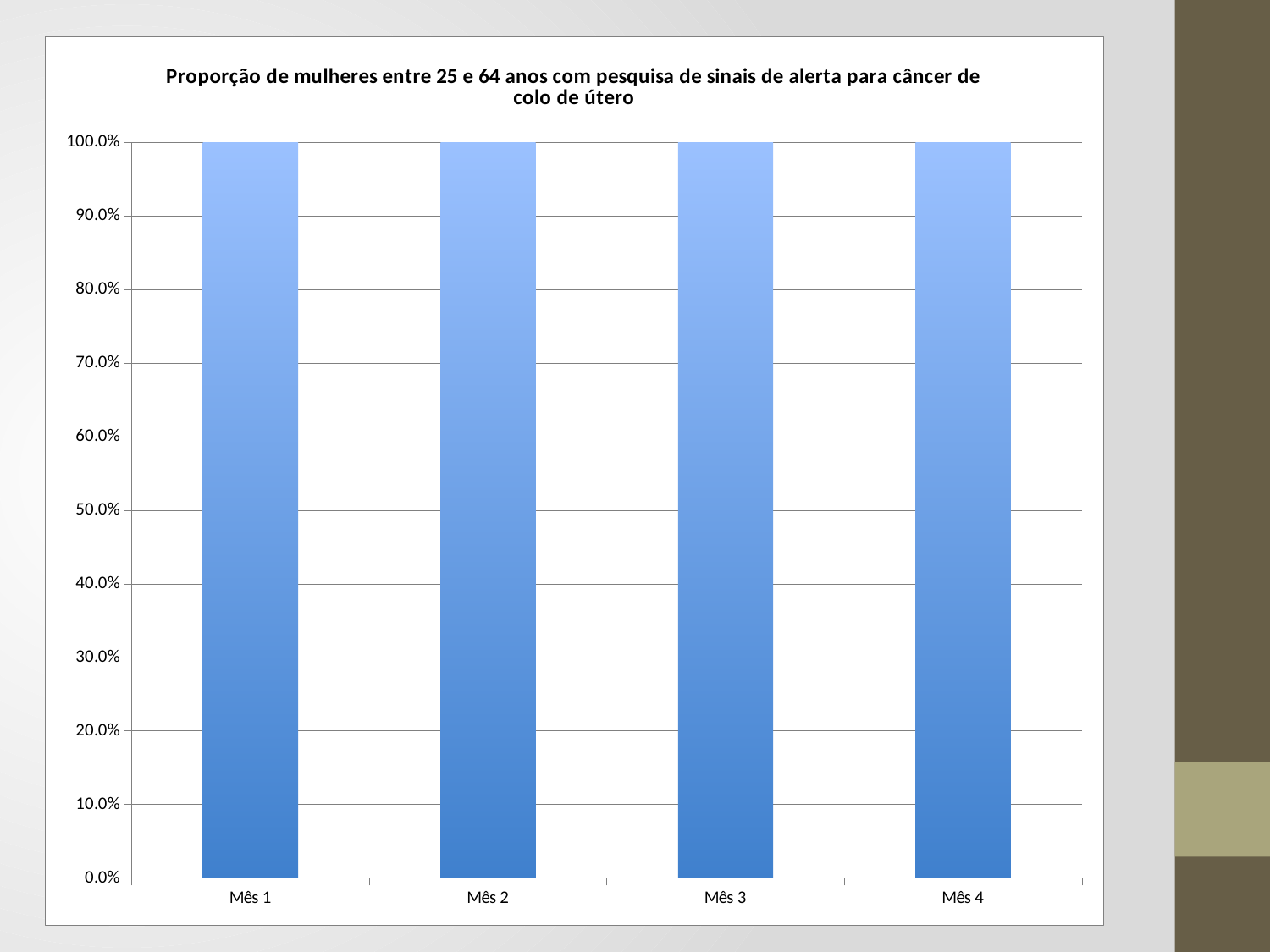
What kind of chart is shown on the slide? bar chart What is the value for Mês 3? 100.0% How many categories (months) are shown on the x axis? 4 What is the value for Mês 2? 100.0% What is the value for Mês 1? 100.0% Is the value for Mês 3 greater or less than 90.0%? greater Is the value for Mês 1 greater or less than 50.0%? greater Do the values rise, fall, or stay the same from Mês 1 to Mês 4? stay the same What colour are the bars in the chart? blue What is the title of the chart? Proporção de mulheres entre 25 e 64 anos com pesquisa de sinais de alerta para câncer de colo de útero What is the difference between the values for Mês 1 and Mês 4? 0.0% What is the value for Mês 4? 100.0%